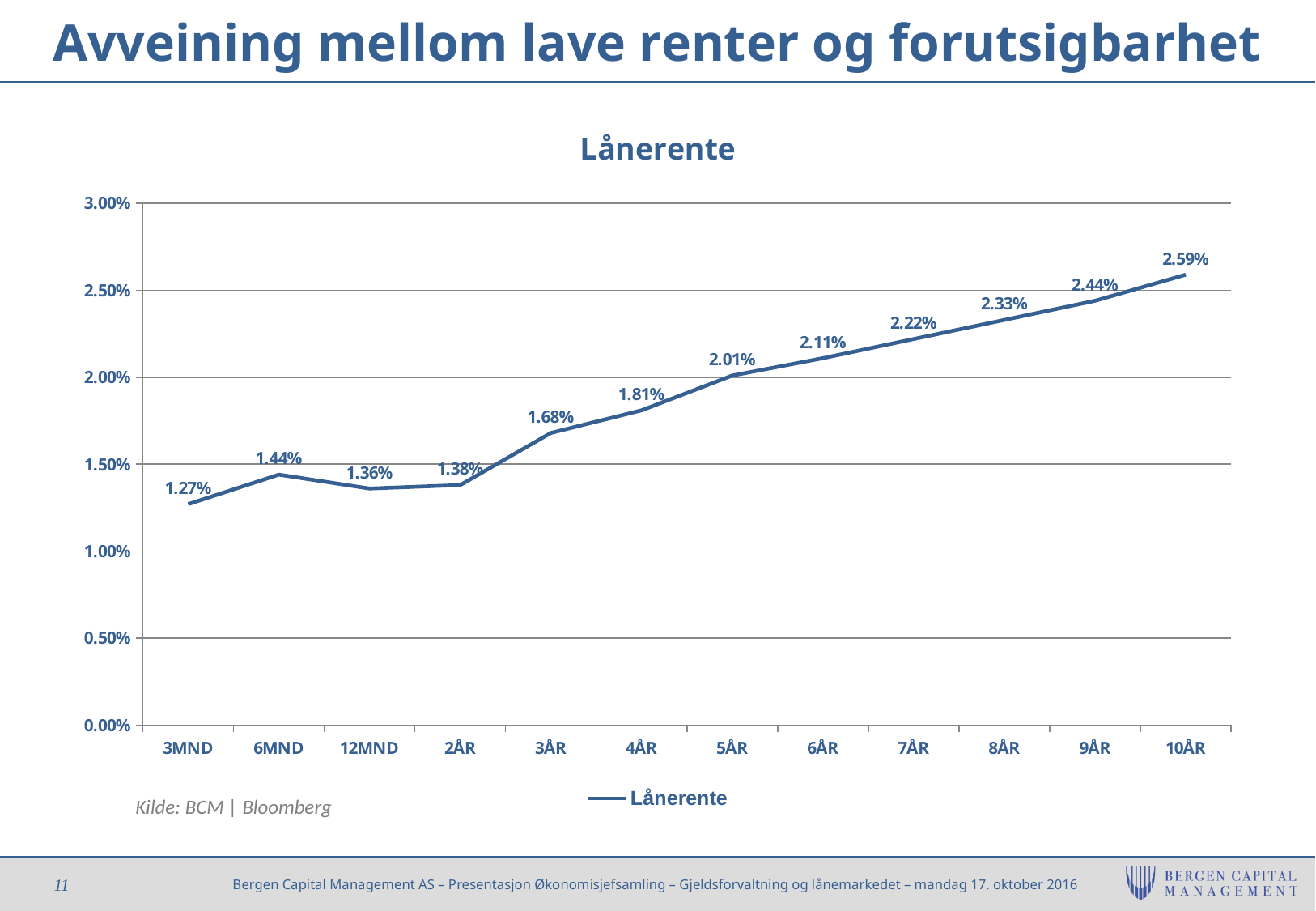
How many categories are shown on the x axis? 12 Is the Lånerente value for 4ÅR greater or less than 2.00%? less Which category has the highest Lånerente value? 10ÅR Which category has the lowest Lånerente value? 3MND What is the Lånerente value for 5ÅR? 2.01% What is the Lånerente value for 3MND? 1.27% Which has a higher Lånerente value, 6MND or 12MND? 6MND What is the Lånerente value for 10ÅR? 2.59% What is the difference between the Lånerente values for 10ÅR and 3MND? 1.32% What kind of chart is shown on the slide? line chart How many series does the legend list? 1 What is the title of the chart? Lånerente